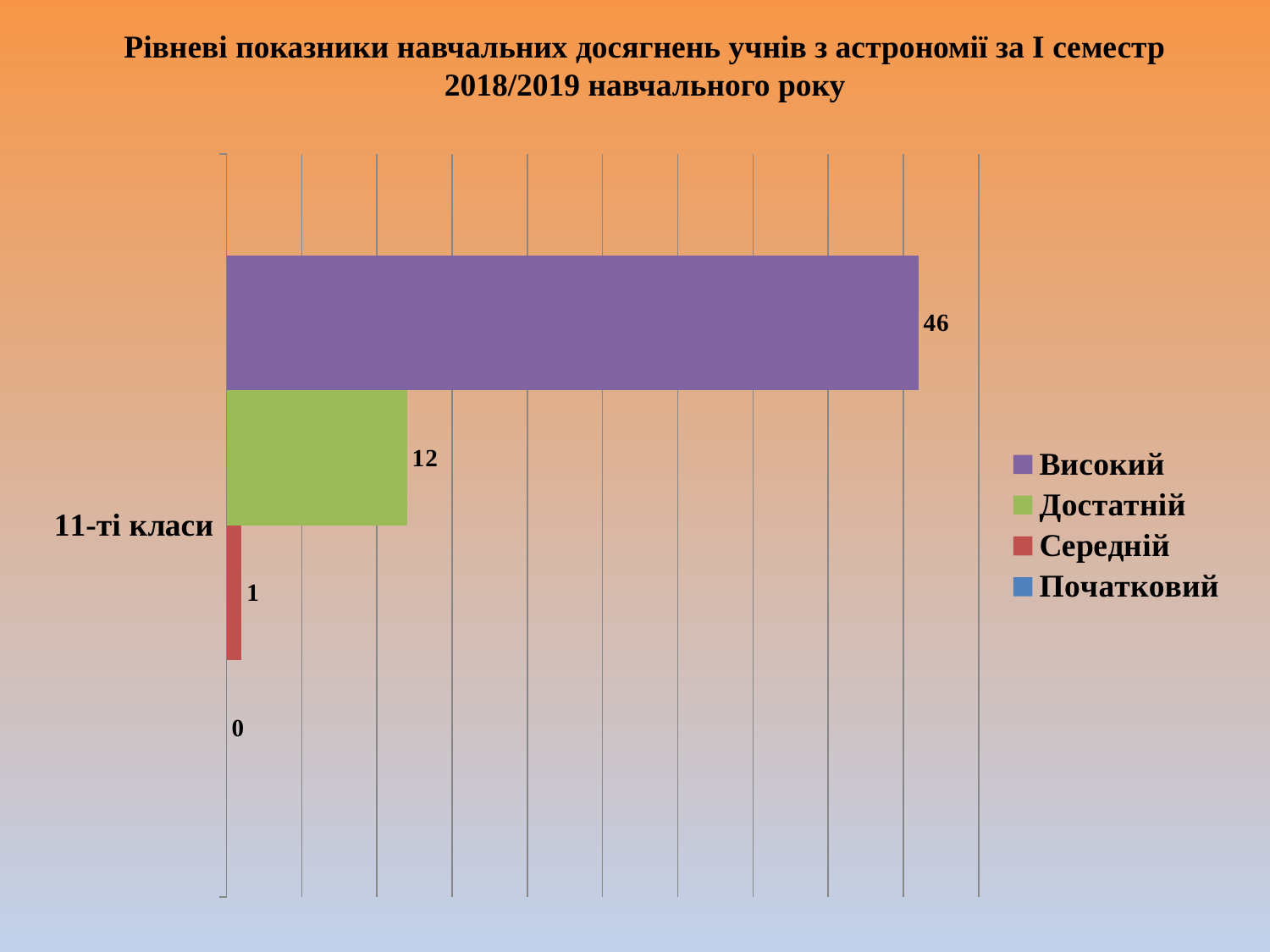
Which series has the lowest value for 11-ті класи? Початковий What is the value for Початковий for 11-ті класи? 0 What kind of chart is shown on the slide? Bar chart What is the value for Середній for 11-ті класи? 1 What is the value for Достатній for 11-ті класи? 12 What is the value for Високий for 11-ті класи? 46 Which is larger for 11-ті класи, Достатній or Середній? Достатній What is the difference between the Високий and Достатній values for 11-ті класи? 34 How many series does the legend list? 4 What colour is the bar for Високий? Purple What is the difference between the Достатній and Середній values for 11-ті класи? 11 Which series has the highest value for 11-ті класи? Високий